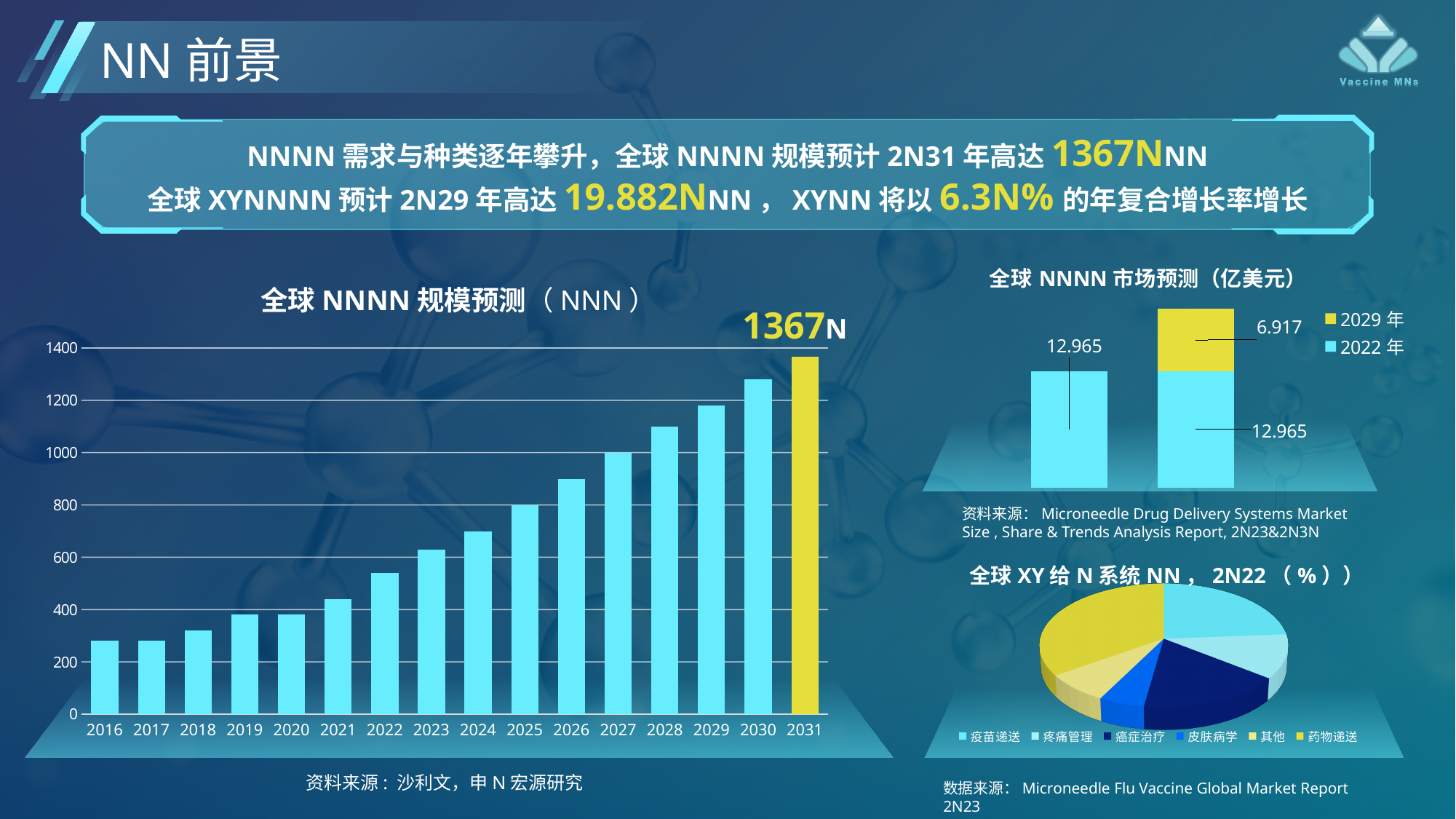
What kind of chart is the left chart '全球 NNNN 规模预测（NNN）'? bar chart In the left chart '全球 NNNN 规模预测（NNN）', which is larger, the bar for 2022 or the bar for 2027? 2027 In the left chart '全球 NNNN 规模预测（NNN）', which year has the highest bar? 2031 In the left chart '全球 NNNN 规模预测（NNN）', is the value for 2016 greater or less than 400? less In the top-right chart '全球 NNNN 市场预测（亿美元）', what is the total of the stacked bar on the right? 19.882 In the left chart '全球 NNNN 规模预测（NNN）', what value is labeled for 2031? 1367N In the left chart '全球 NNNN 规模预测（NNN）', do the values rise or fall from 2016 to 2031? rise In the top-right chart '全球 NNNN 市场预测（亿美元）', what is the value of the 2029年 segment? 6.917 How many years are shown on the x axis of the left chart '全球 NNNN 规模预测（NNN）'? 16 How many series does the legend of the top-right chart '全球 NNNN 市场预测（亿美元）' list? 2 In the left chart '全球 NNNN 规模预测（NNN）', is the value for 2028 greater or less than 1000? greater How many slices does the bottom-right pie chart '全球 XY 给 N 系统 NN，2N22（%）' have according to its legend? 6